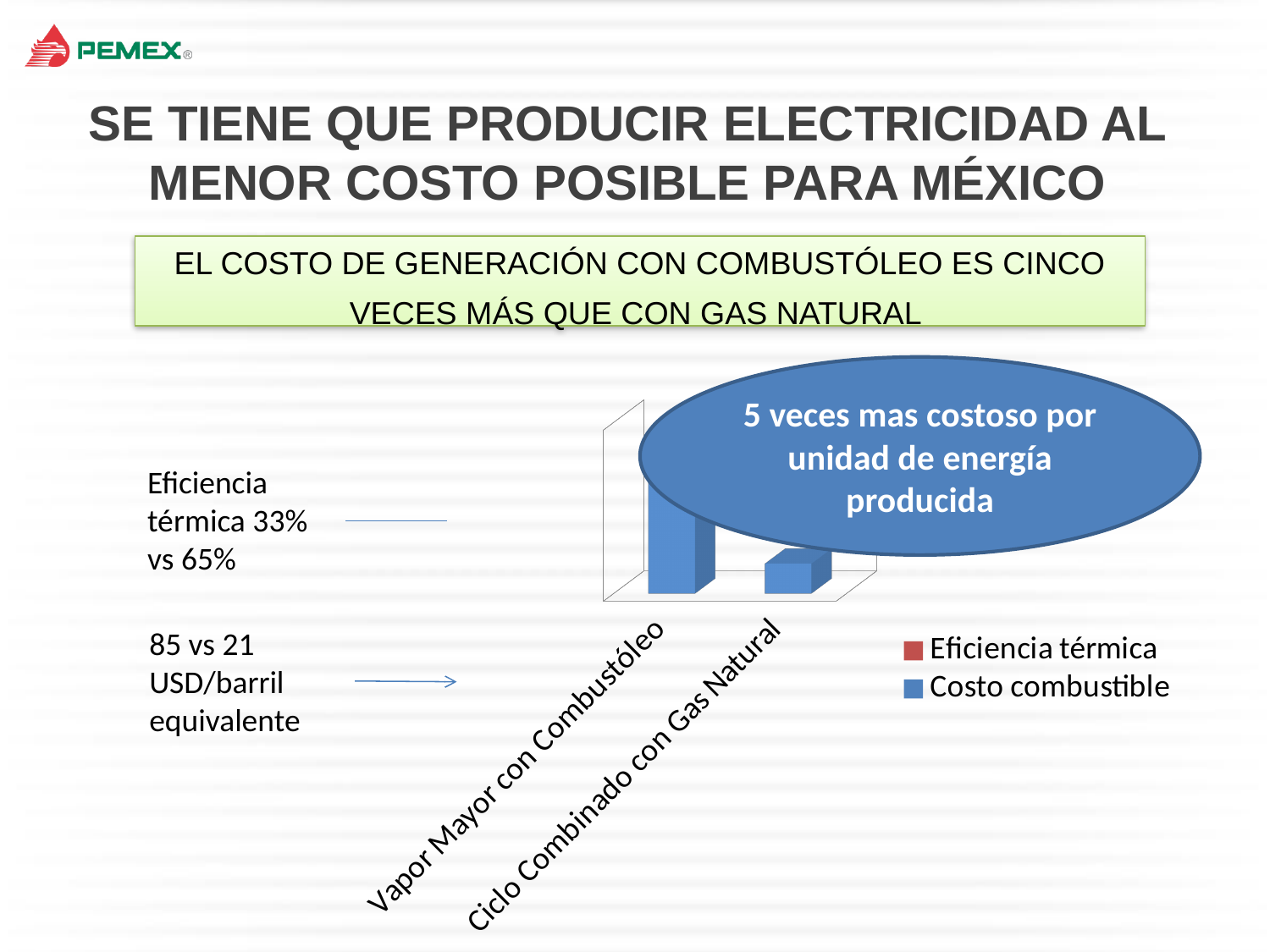
Which category has the tallest bar in the chart? Vapor Mayor con Combustóleo How many series does the chart legend list? 2 Is the bar for Vapor Mayor con Combustóleo taller or shorter than the bar for Ciclo Combinado con Gas Natural? taller How many categories are shown on the x axis of the chart? 2 What kind of chart is shown on the slide? bar chart Which category has the shortest bar in the chart? Ciclo Combinado con Gas Natural What are the two series names listed in the chart legend? Eficiencia térmica, Costo combustible Which series is shown in blue in the chart legend? Costo combustible